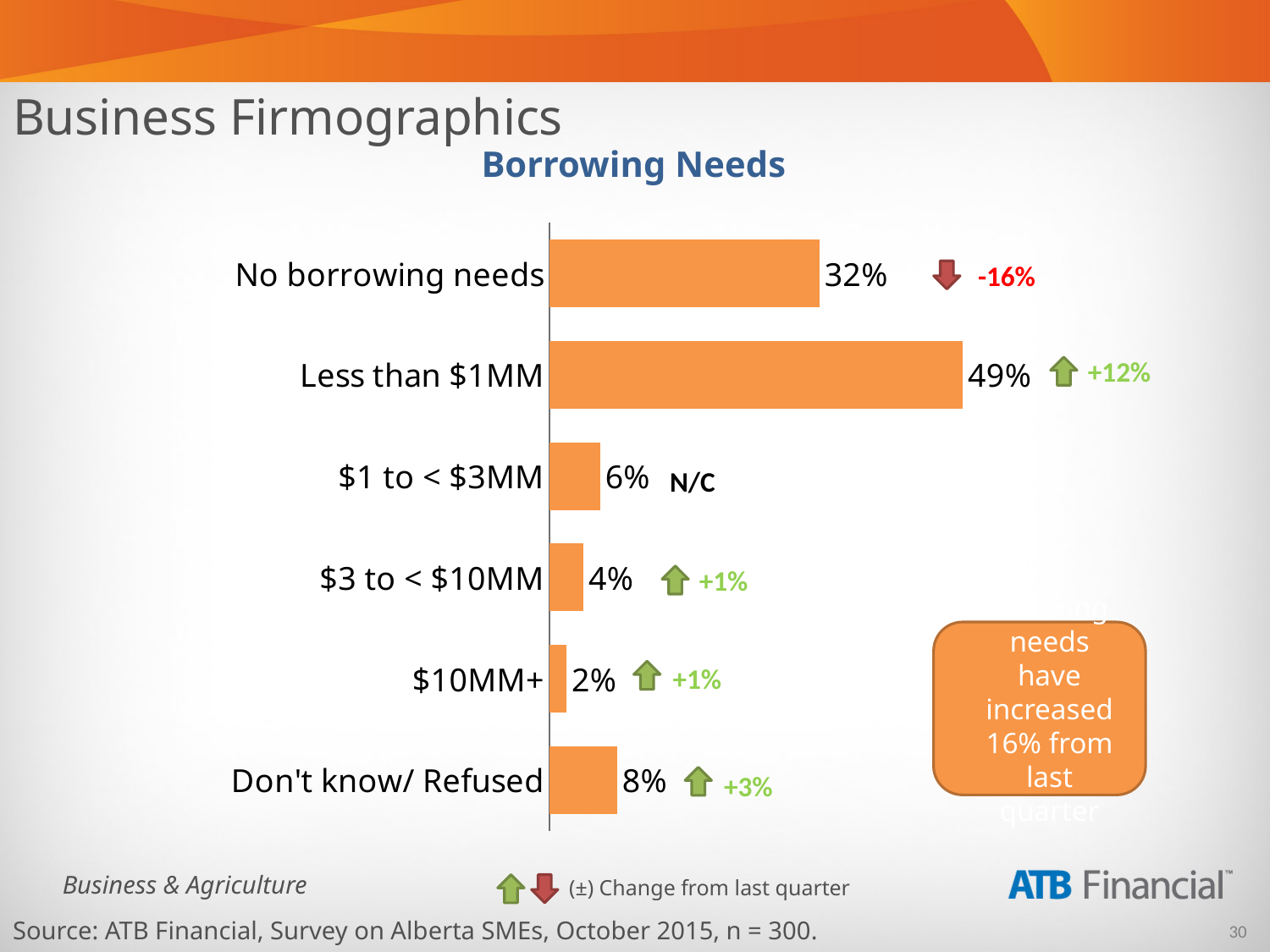
What is the difference between the values for "Less than $1MM" and "No borrowing needs"? 17% What is the value for "Don't know/ Refused"? 8% What kind of chart is shown on the slide? Bar chart What is the value for "Less than $1MM"? 49% Which category has the lowest value? $10MM+ Which is larger, the value for "$1 to < $3MM" or the value for "$3 to < $10MM"? $1 to < $3MM What is the change from last quarter shown for "$1 to < $3MM"? N/C What is the value for "No borrowing needs"? 32% What is the change from last quarter shown for "No borrowing needs"? -16% Which category has the highest value? Less than $1MM How many categories are shown in the chart? 6 What is the title of the chart? Borrowing Needs